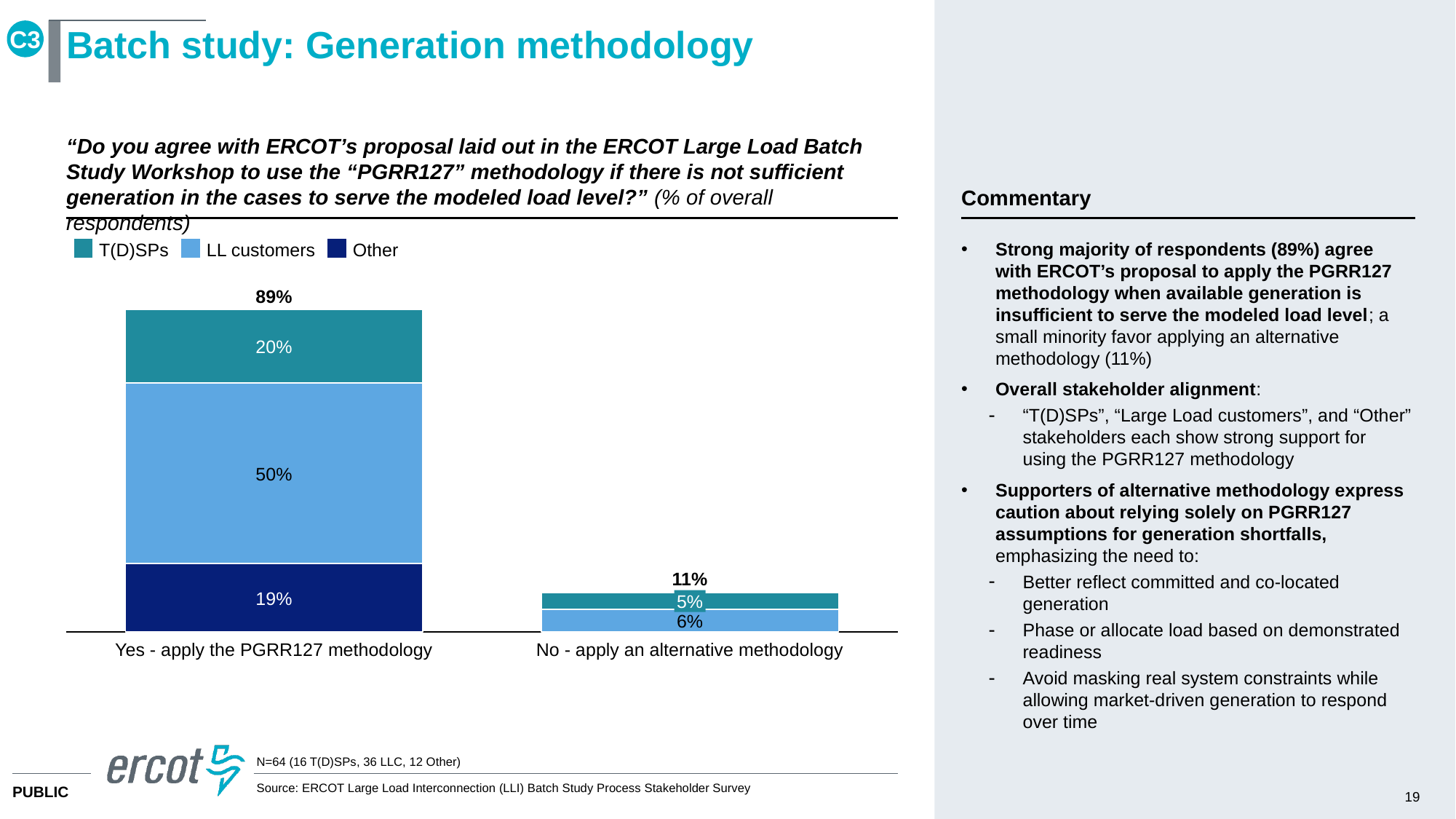
How many series does the legend list? 3 What is the T(D)SPs value in the 'Yes - apply the PGRR127 methodology' bar? 20% What is the T(D)SPs value in the 'No - apply an alternative methodology' bar? 5% What is the LL customers value in the 'Yes - apply the PGRR127 methodology' bar? 50% What is the LL customers value in the 'No - apply an alternative methodology' bar? 6% Which response category has the highest total? Yes - apply the PGRR127 methodology What is the total for the 'Yes - apply the PGRR127 methodology' bar? 89% What is the total for the 'No - apply an alternative methodology' bar? 11% What is the difference between the totals of the 'Yes' bar and the 'No' bar? 78% What kind of chart is shown on the slide? Stacked bar chart What is the Other value in the 'Yes - apply the PGRR127 methodology' bar? 19% Which is larger: the T(D)SPs value in the 'Yes' bar or the T(D)SPs value in the 'No' bar? Yes bar (20%)